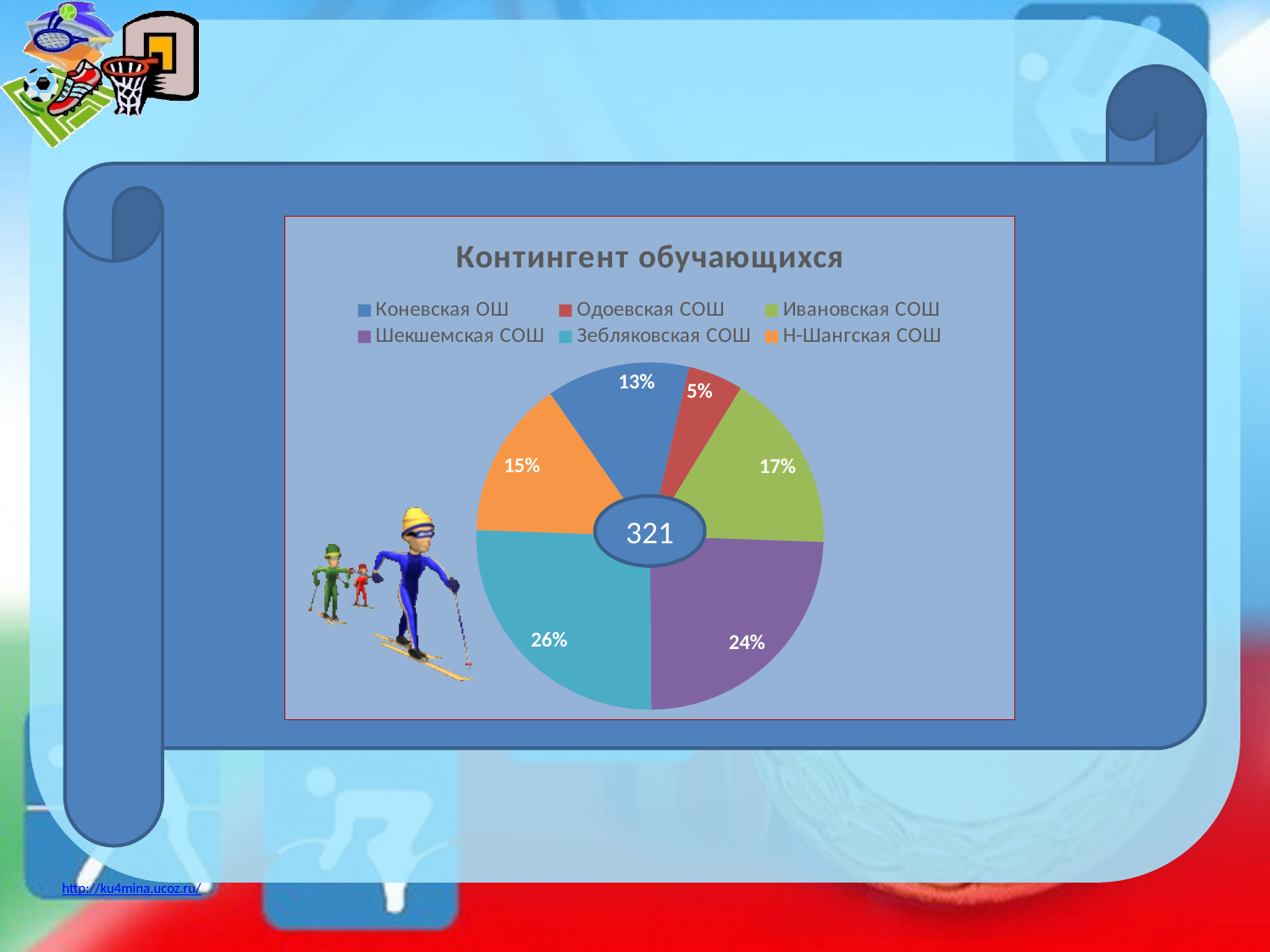
Which school has the smallest slice of the pie? Одоевская СОШ How many categories does the pie chart have? 6 Which is larger, the share for Ивановская СОШ or the share for Коневская ОШ? Ивановская СОШ What share of the pie does Зебляковская СОШ have? 26% What number is shown in the centre of the pie chart? 321 What kind of chart is shown on the slide? pie chart What share of the pie does Коневская ОШ have? 13% What share of the pie does Одоевская СОШ have? 5% Which school has the largest slice of the pie? Зебляковская СОШ What is the difference in percentage points between Ивановская СОШ and Н-Шангская СОШ? 2 What is the title of the chart? Контингент обучающихся